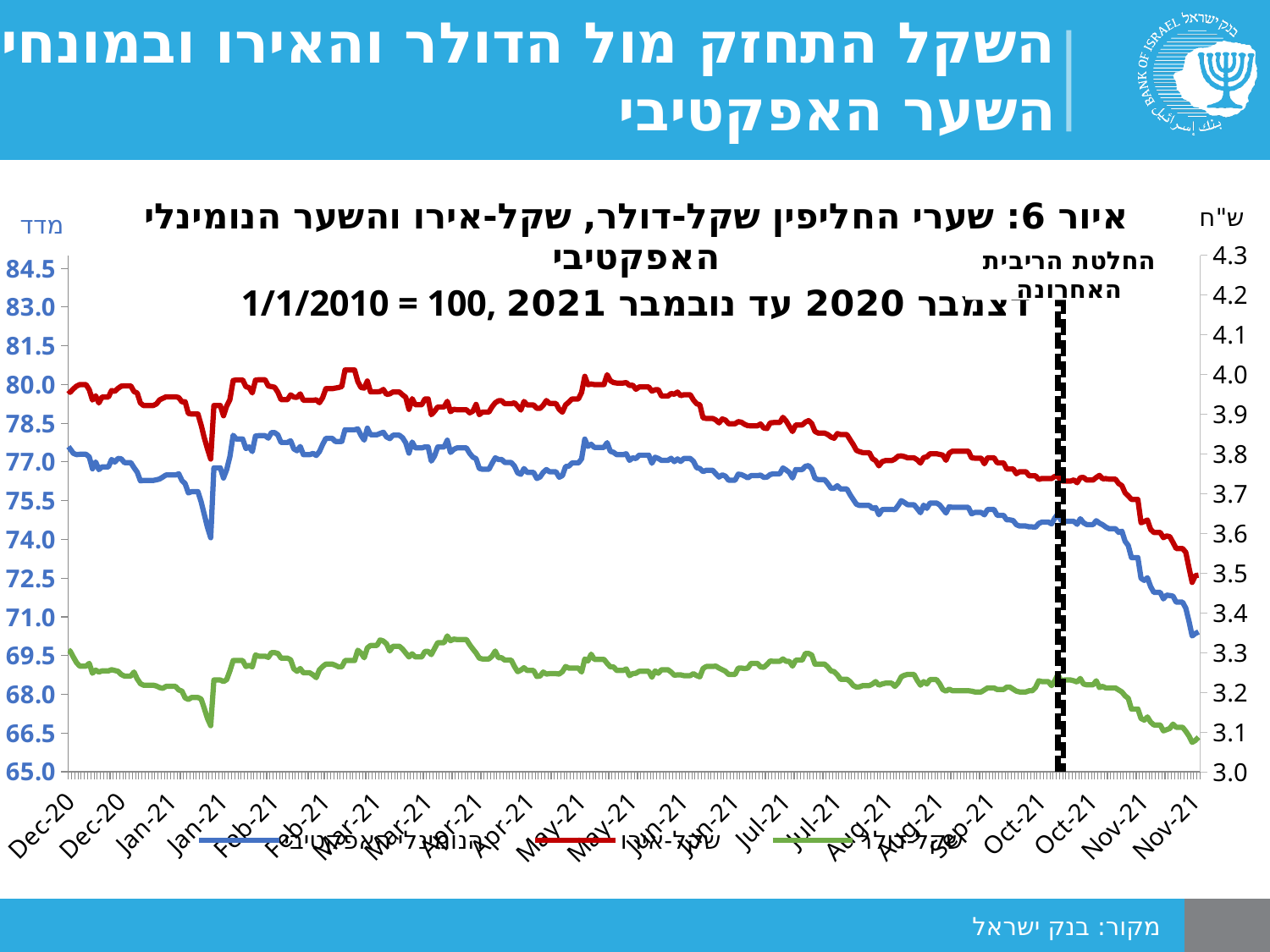
Is the value of the green line (shekel-dollar) at its peak around Apr-21 greater or less than 3.3 on the right axis? greater What does the dashed vertical line near Oct-21 mark, according to its label? החלטת הריבית האחרונה Is the value of the red line (shekel-euro) at the start of the period (Dec-20) greater or less than 3.9 on the right axis? greater Does the blue line (nominal effective exchange rate index) rise or fall overall from Dec-20 to Nov-21? Fall Is the value of the blue line at the start of the period (Dec-20) greater or less than 77.0 on the left axis? greater What kind of chart is shown on the slide? Line chart Does the red line (shekel-euro) rise or fall overall from Dec-20 to Nov-21? Fall What base value does the chart's subtitle state for the index (1/1/2010)? 100 How many series does the chart's legend list? 3 Does the green line (shekel-dollar) rise or fall overall from Dec-20 to Nov-21? Fall